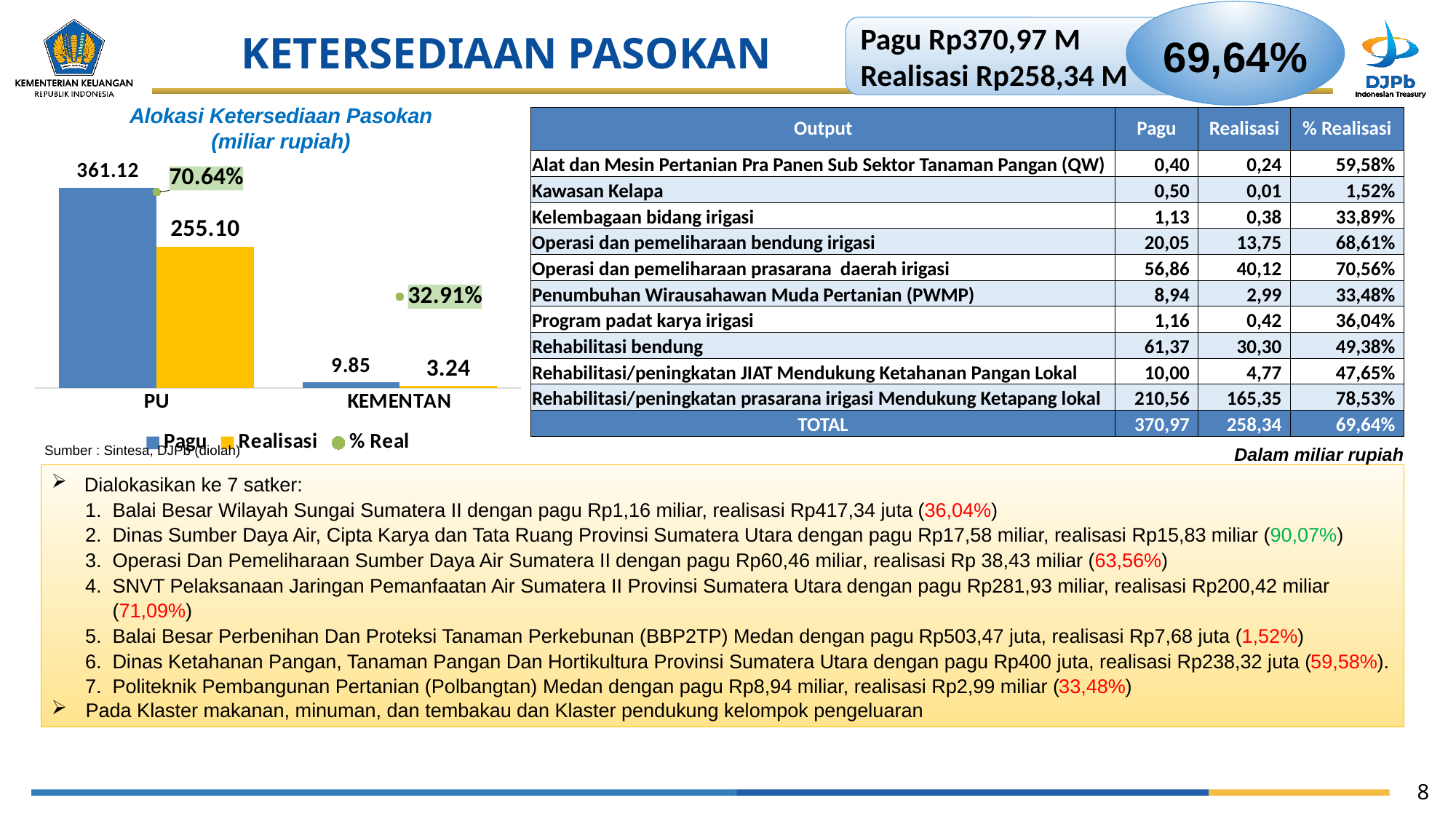
How many categories are shown on the x axis of the chart? 2 Which category has the highest Pagu value in the chart? PU What is the difference between the Pagu values for PU and KEMENTAN in the chart? 351.27 Which is larger in the chart: the Realisasi for PU or the Pagu for KEMENTAN? Realisasi for PU What is the % Real value shown for KEMENTAN in the chart? 32.91% What type of chart is used to show the Pagu and Realisasi values? Bar chart What is the Realisasi value for KEMENTAN in the chart? 3.24 What is the Pagu value for PU in the chart? 361.12 How many series does the chart legend list? 3 What is the % Real value shown for PU in the chart? 70.64% What is the difference between the Pagu and Realisasi values for PU in the chart? 106.02 Which category has the lowest Realisasi value in the chart? KEMENTAN